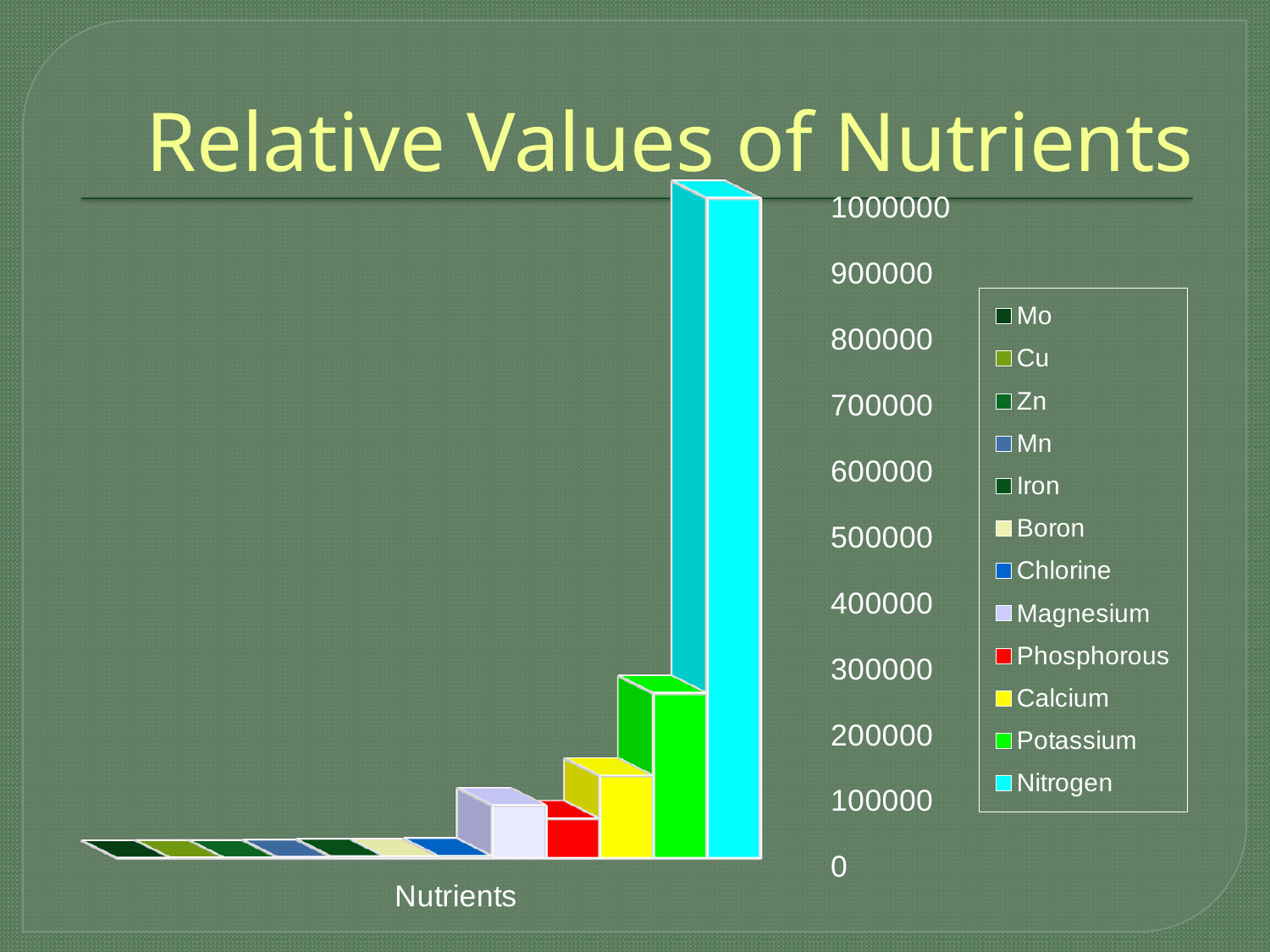
How many series does the legend list? 12 Is the value for Phosphorous greater or less than 200000? less Is the value for Nitrogen greater or less than 900000? greater Which has the larger value, Potassium or Calcium? Potassium What is the label on the horizontal axis of the chart? Nutrients What is the title of the chart? Relative Values of Nutrients Is the value for Calcium greater or less than 200000? less Which has the larger value, Magnesium or Phosphorous? Magnesium What kind of chart is shown on the slide? bar chart Which has the larger value, Nitrogen or Potassium? Nitrogen Which nutrient has the highest value in the chart? Nitrogen